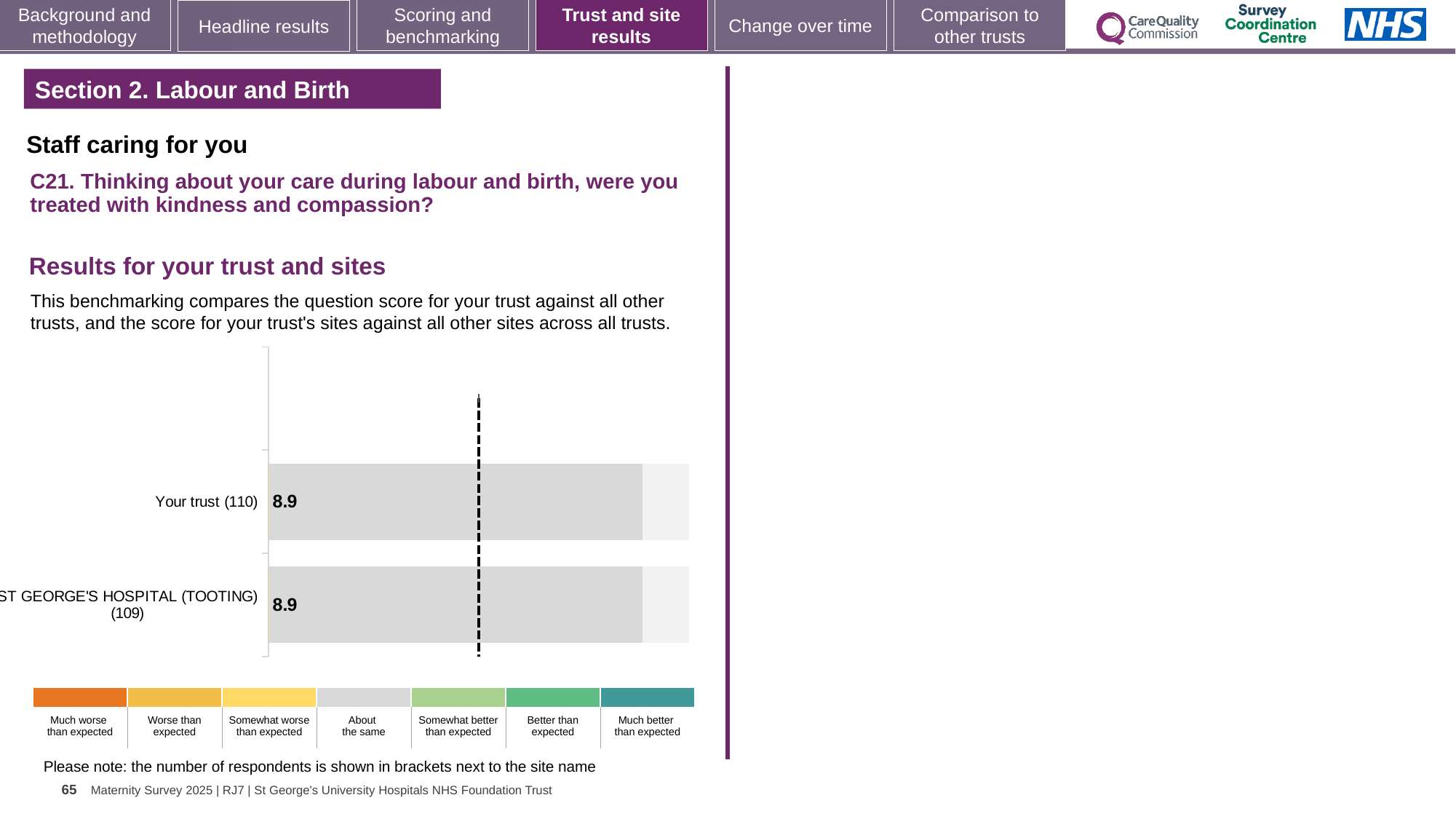
How many bars are plotted in the chart? 2 Which survey question does the chart relate to? C21. Thinking about your care during labour and birth, were you treated with kindness and compassion? How many respondents are shown in brackets for Your trust? 110 What kind of chart is shown on the slide? Bar chart What is the score for ST GEORGE'S HOSPITAL (TOOTING) (109)? 8.9 How many categories does the colour key below the chart list? 7 What is the difference between the score for Your trust and the score for ST GEORGE'S HOSPITAL (TOOTING)? 0 Which category in the colour key does the grey colour of the bars correspond to? About the same How many respondents are shown in brackets for ST GEORGE'S HOSPITAL (TOOTING)? 109 What is the score for Your trust (110)? 8.9